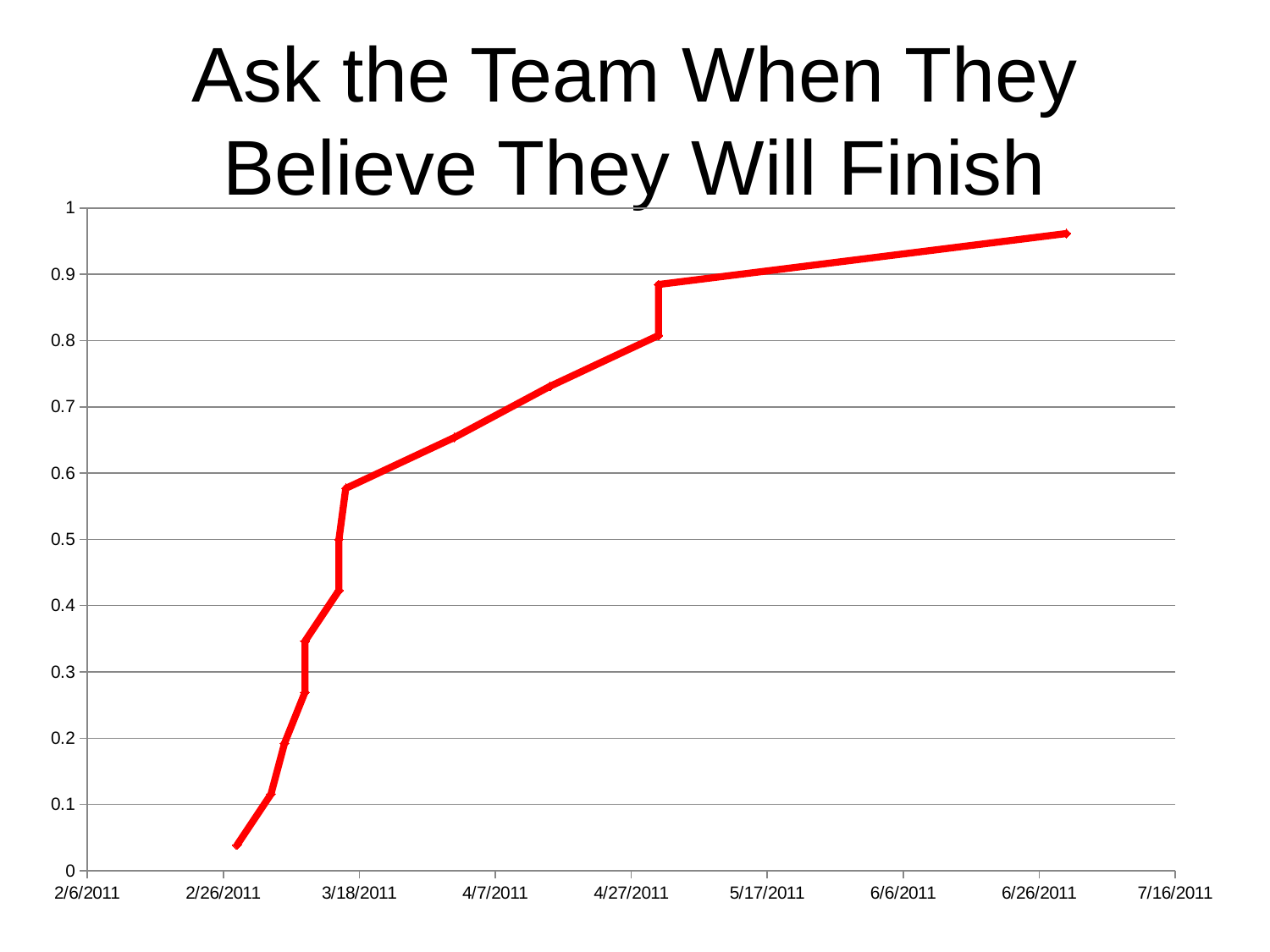
What is the title of the chart? Ask the Team When They Believe They Will Finish Do the plotted values rise or fall as the dates move from left to right along the x axis? rise Is the value of the last plotted point (near 6/26/2011) greater or less than 0.9? greater Which is larger, the value of the line at 4/7/2011 or at 5/17/2011? 5/17/2011 Is the value of the line at 4/27/2011 greater or less than 0.5? greater Is the value of the line at 5/17/2011 greater or less than 0.8? greater What is the highest value shown on the y axis? 1 What kind of chart is shown on the slide? line chart How many lines (series) are plotted on the chart? 1